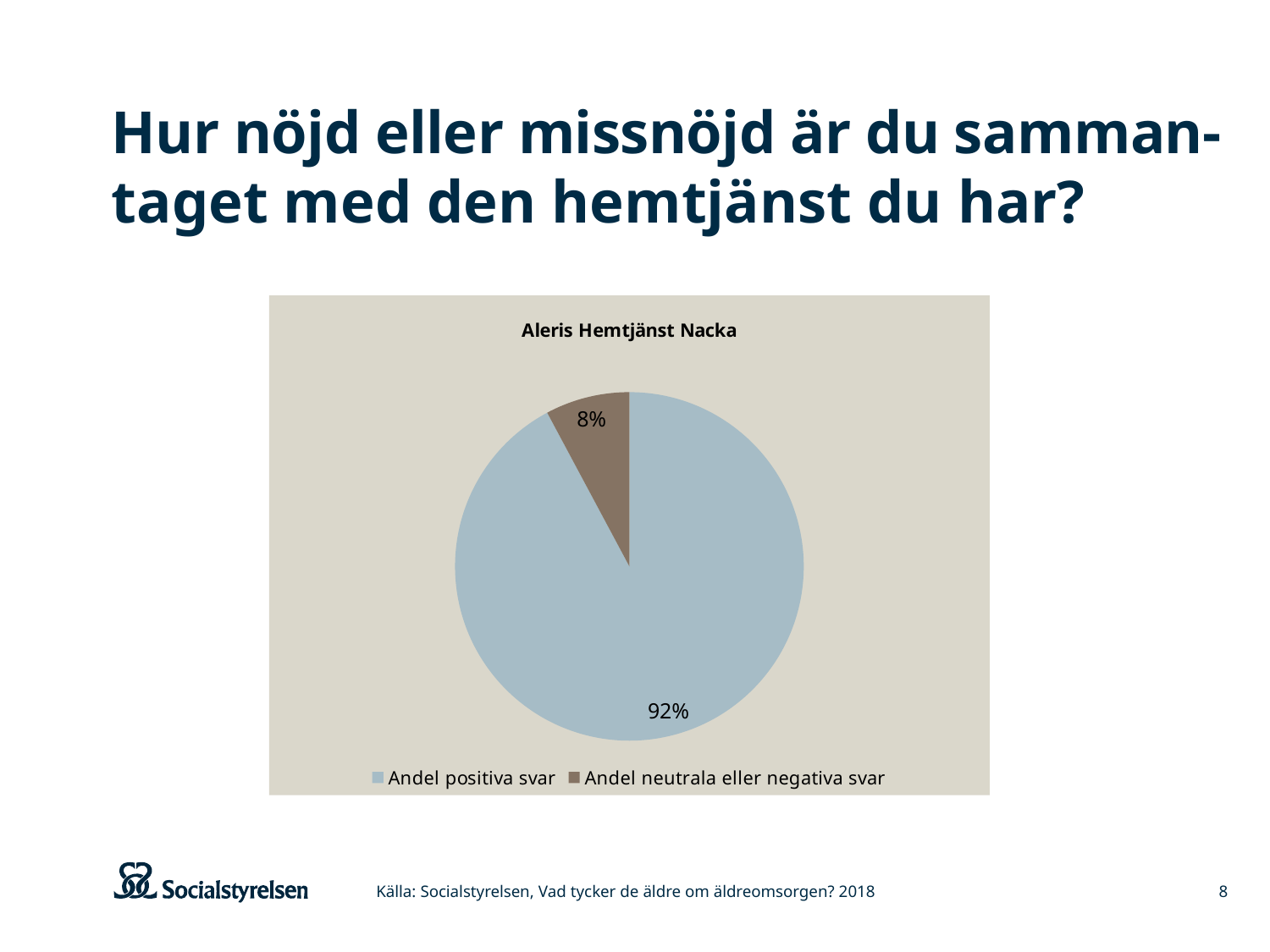
Which slice is the smallest? Andel neutrala eller negativa svar What kind of chart is shown on the slide? pie chart What colour is the slice for "Andel neutrala eller negativa svar"? brown What is the value for "Andel neutrala eller negativa svar"? 8% How many entries does the legend list? 2 Which slice is the largest? Andel positiva svar Which is larger, "Andel positiva svar" or "Andel neutrala eller negativa svar"? Andel positiva svar What share of the pie does "Andel positiva svar" take? 92% What is the difference between "Andel positiva svar" and "Andel neutrala eller negativa svar"? 84 percentage points How many slices does the pie chart have? 2 What is the value for "Andel positiva svar"? 92% What is the title of the chart? Aleris Hemtjänst Nacka